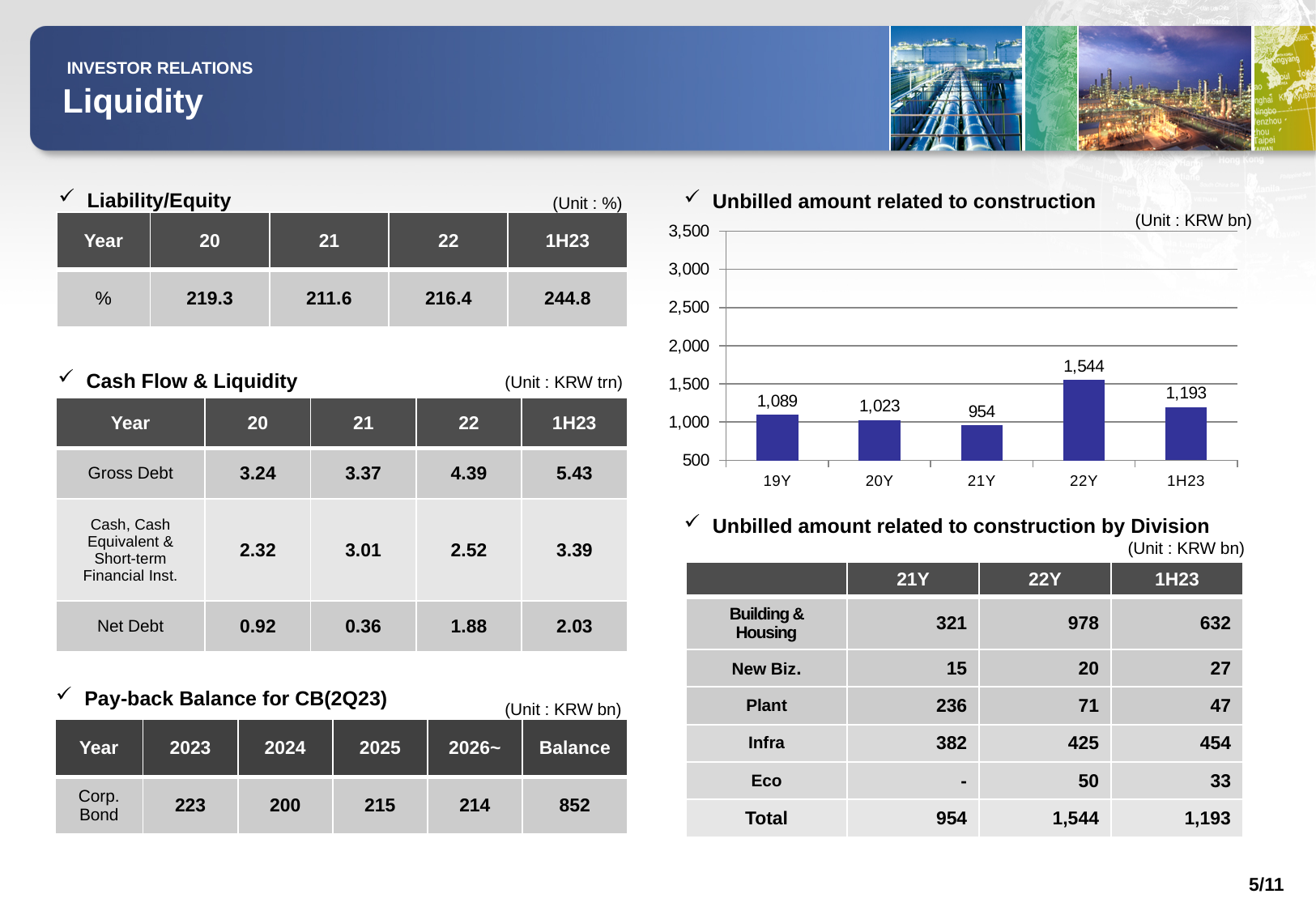
In the 'Unbilled amount related to construction' chart, which is larger, the value for 20Y or the value for 1H23? 1H23 What kind of chart is 'Unbilled amount related to construction'? bar chart In the 'Unbilled amount related to construction' chart, what is the value for 22Y? 1,544 In the 'Unbilled amount related to construction' chart, which period has the highest value? 22Y In the 'Unbilled amount related to construction' chart, what is the difference between the 22Y and 21Y values? 590 In the 'Unbilled amount related to construction' chart, what is the value for 19Y? 1,089 In the 'Unbilled amount related to construction' chart, which period has the lowest value? 21Y In the 'Unbilled amount related to construction' chart, what is the value for 1H23? 1,193 In the 'Unbilled amount related to construction' chart, is the value for 22Y greater or less than 1,500? greater How many periods are shown on the x axis of the 'Unbilled amount related to construction' chart? 5 What unit is stated for the 'Unbilled amount related to construction' chart? KRW bn In the 'Unbilled amount related to construction' chart, what is the difference between the 19Y and 20Y values? 66